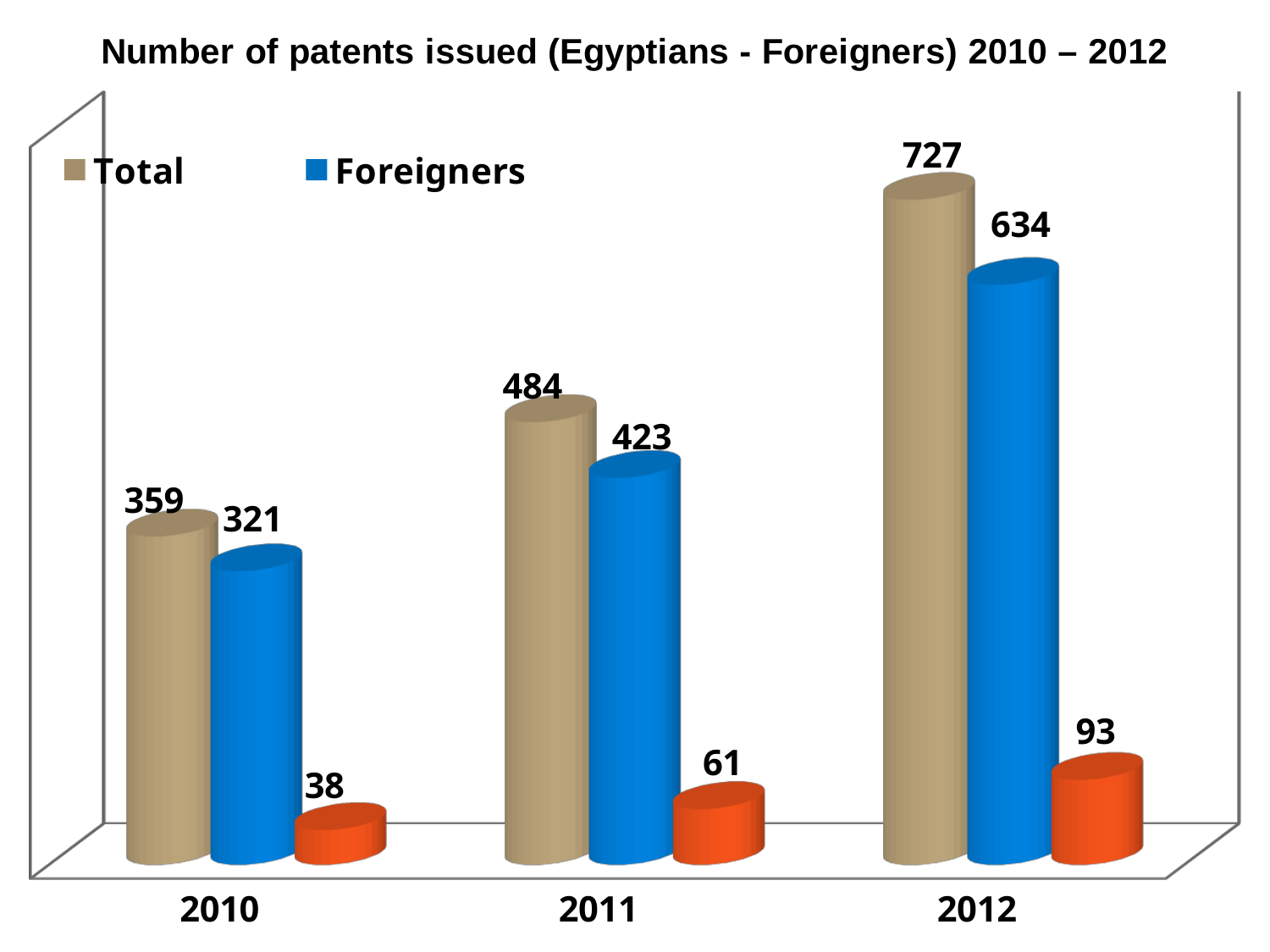
Which is larger, the Foreigners value for 2011 or the Total value for 2010? Foreigners value for 2011 What is the Total value for 2012? 727 How many years are shown on the x axis? 3 What is the Foreigners value for 2011? 423 How many series does the legend list? 2 What kind of chart is shown on the slide? Bar chart What is the Foreigners value for 2012? 634 What is the difference between the Total values for 2012 and 2010? 368 What is the difference between the Total and Foreigners values in 2011? 61 In which year is the Total value highest? 2012 In which year is the Foreigners value lowest? 2010 What is the Total value for 2010? 359